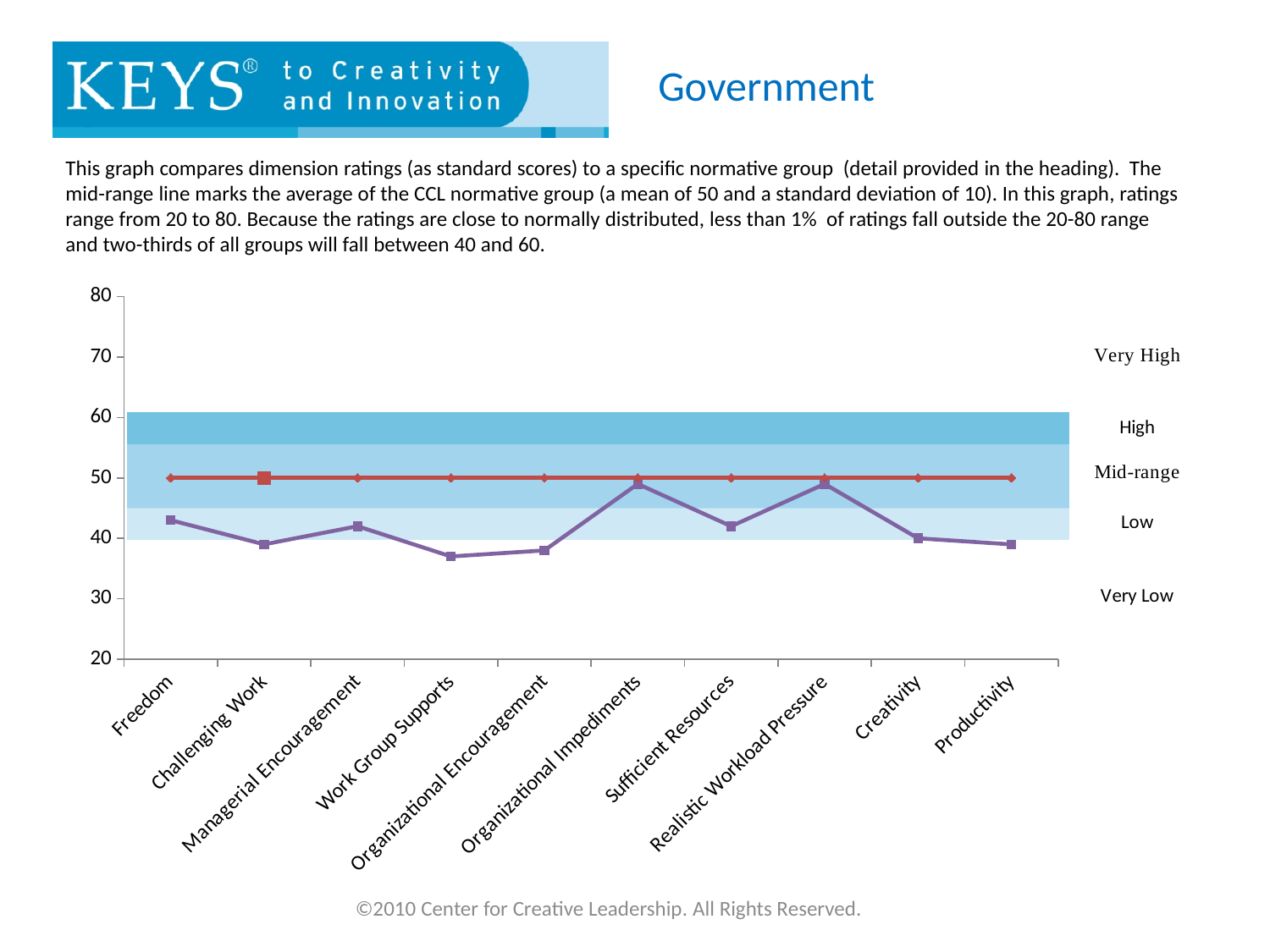
What value does the red mid-range line sit at on the chart? 50 Is the value for Work Group Supports greater or less than 40? less Is the value for Realistic Workload Pressure greater or less than 40? greater What kind of chart is shown on the slide? line chart Is the value for Challenging Work greater or less than 50? less What is the title of the slide containing the chart? Government How many dimensions are plotted along the x axis of the chart? 10 Which is larger, the value for Freedom or the value for Work Group Supports? Freedom What label is shown to the right of the chart at the level of the red line? Mid-range Which is larger, the value for Organizational Impediments or the value for Creativity? Organizational Impediments